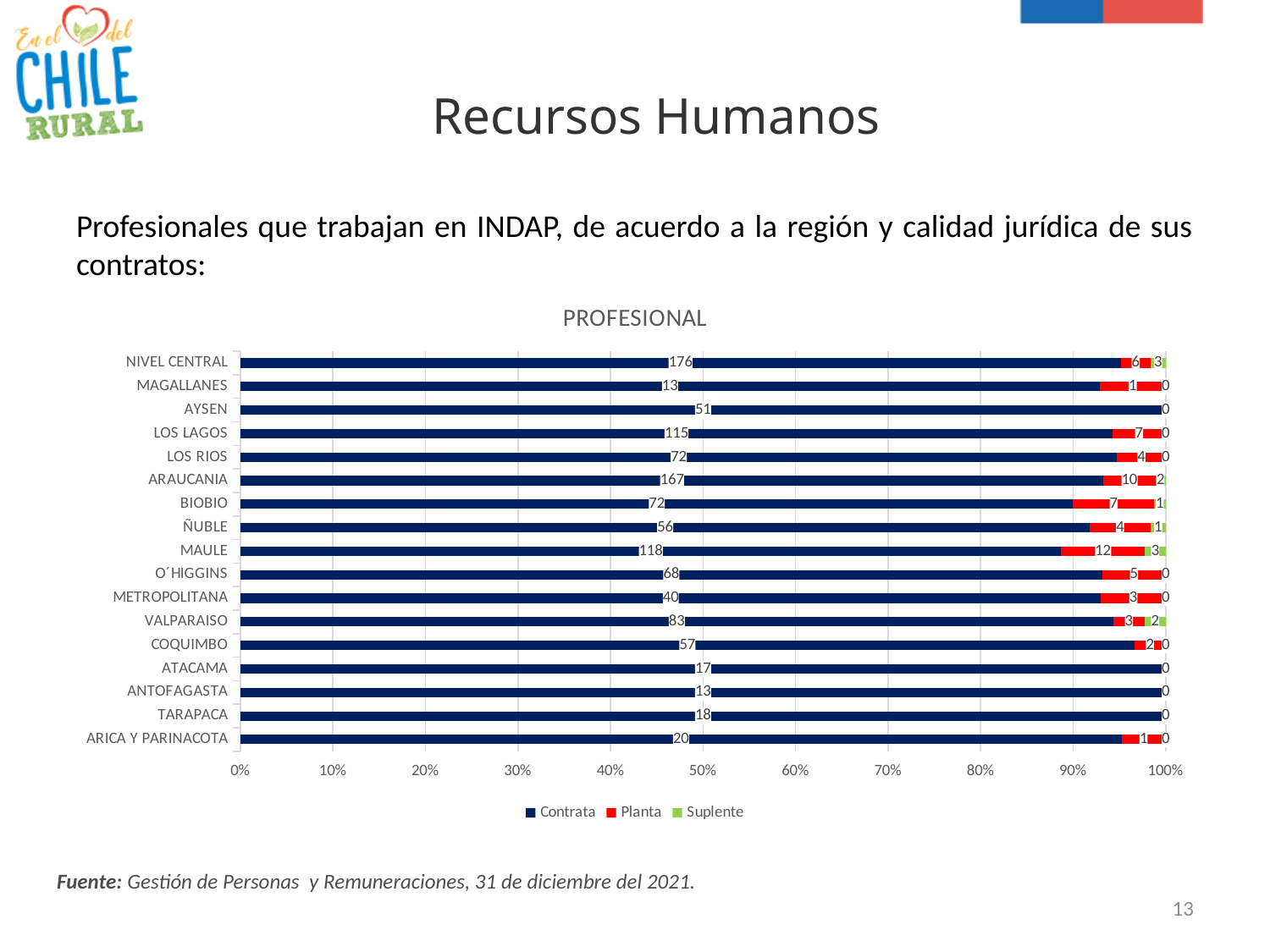
Which region has the highest Contrata value? NIVEL CENTRAL How many series does the legend list? 3 What is the total number of professionals for MAULE across Contrata, Planta and Suplente? 133 Which region has the highest Planta value? MAULE What kind of chart is shown? Stacked bar chart How many regions are shown on the chart? 17 What is the Contrata value for NIVEL CENTRAL? 176 Which has a larger Contrata value, LOS LAGOS or MAULE? MAULE What is the difference between the Contrata values for NIVEL CENTRAL and ARAUCANIA? 9 What is the Planta value for MAULE? 12 What is the Contrata value for VALPARAISO? 83 What is the Suplente value for ARAUCANIA? 2